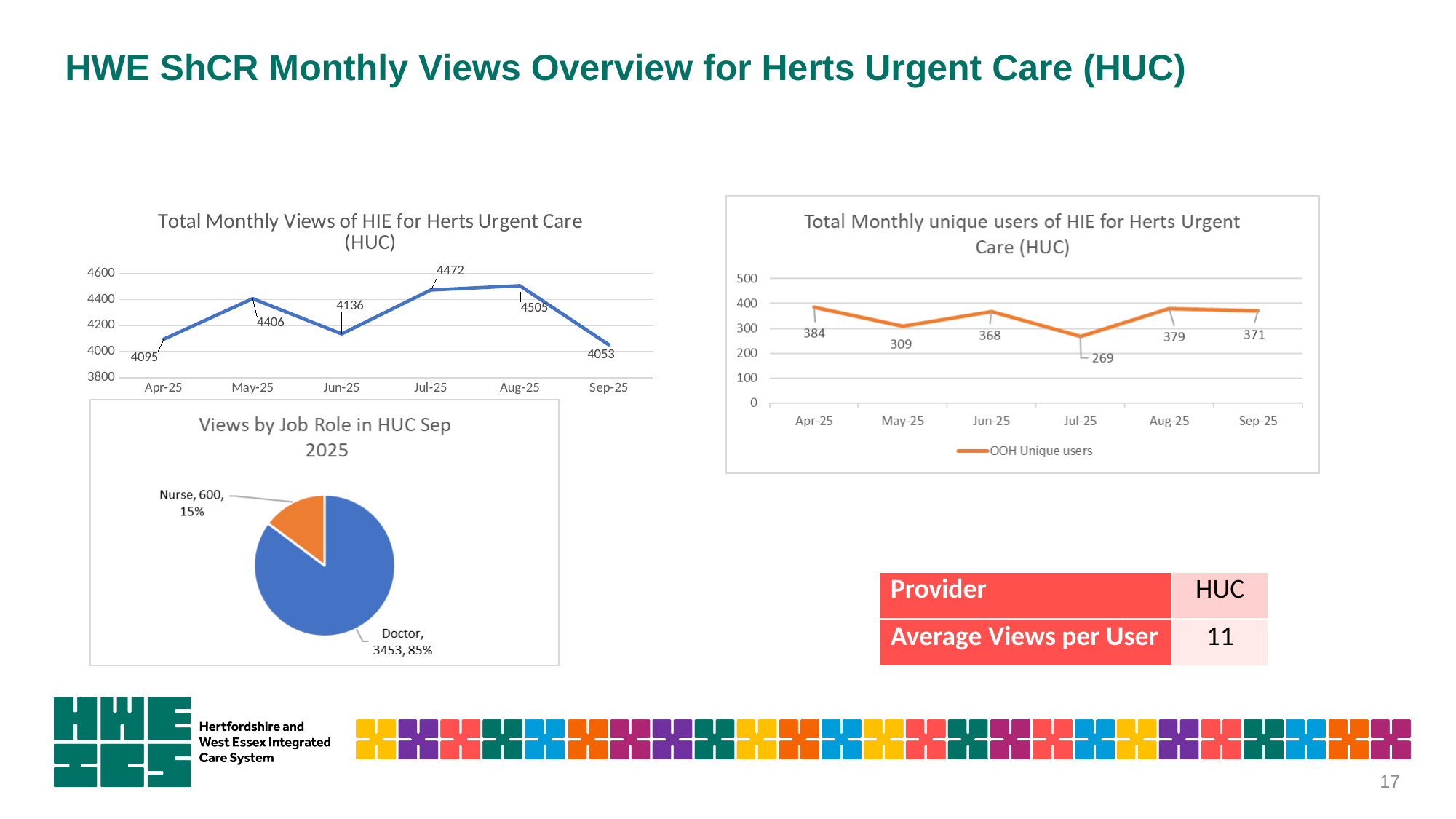
In the 'Views by Job Role in HUC Sep 2025' chart, what is the value for Nurse? 600 In the 'Total Monthly unique users of HIE for Herts Urgent Care (HUC)' chart, is the value for Jun-25 larger or the value for May-25? Jun-25 What kind of chart is 'Views by Job Role in HUC Sep 2025'? Pie chart In the 'Total Monthly unique users of HIE for Herts Urgent Care (HUC)' chart, which month has the highest value? Apr-25 In the 'Total Monthly unique users of HIE for Herts Urgent Care (HUC)' chart, what series name does the legend show? OOH Unique users In the 'Total Monthly Views of HIE for Herts Urgent Care (HUC)' chart, which month has the highest value? Aug-25 In the 'Total Monthly Views of HIE for Herts Urgent Care (HUC)' chart, which month has the lowest value? Sep-25 In the 'Views by Job Role in HUC Sep 2025' chart, what share of views is from Doctors? 85% In the 'Total Monthly Views of HIE for Herts Urgent Care (HUC)' chart, what is the difference between the Aug-25 and Sep-25 values? 452 In the 'Total Monthly unique users of HIE for Herts Urgent Care (HUC)' chart, what is the value for Jul-25? 269 In the 'Total Monthly Views of HIE for Herts Urgent Care (HUC)' chart, what is the value for Jul-25? 4472 In the 'Total Monthly Views of HIE for Herts Urgent Care (HUC)' chart, how many months are plotted? 6